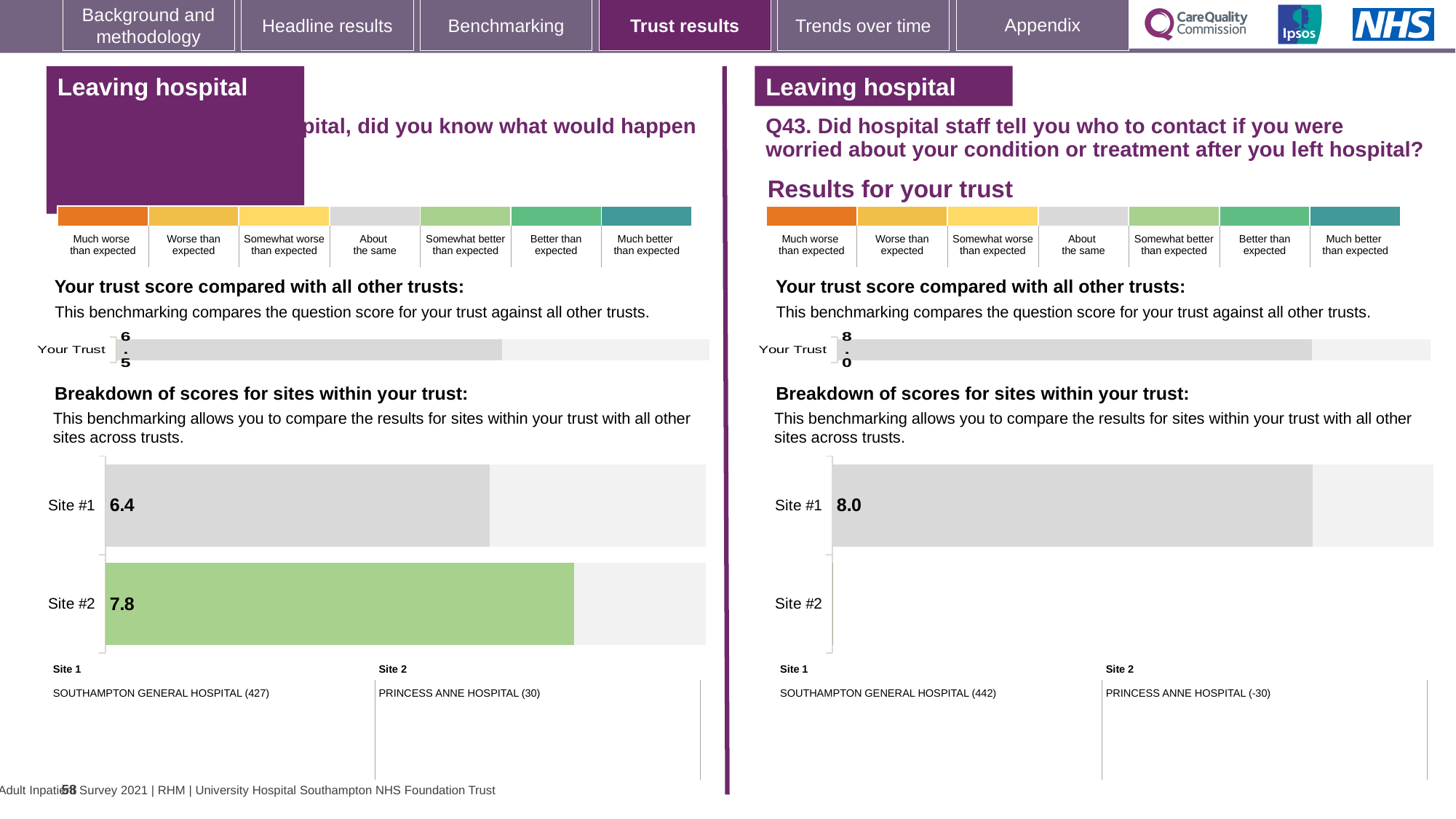
In the left-hand 'Breakdown of scores for sites within your trust' chart, what is the score for Site #2? 7.8 What type of chart is used for the site breakdown on the left-hand side of the slide? Bar chart In the left-hand site breakdown chart, is the score for Site #1 larger or smaller than the score for Site #2? smaller In the left-hand 'Breakdown of scores for sites within your trust' chart, what is the score for Site #1? 6.4 In the left-hand 'Your trust score compared with all other trusts' chart, what is the value shown for Your Trust? 6.5 In the right-hand (Q43) 'Your trust score compared with all other trusts' chart, what is the value shown for Your Trust? 8.0 In the left-hand site breakdown chart, which site has the higher score? Site #2 In the left-hand site breakdown chart, which site has the lower score? Site #1 How many sites are listed in the right-hand (Q43) site breakdown chart? 2 In the left-hand site breakdown chart, what colour is the bar for Site #2? Green In the right-hand (Q43) 'Breakdown of scores for sites within your trust' chart, what is the score for Site #1? 8.0 In the left-hand site breakdown chart, what is the difference between the Site #2 score and the Site #1 score? 1.4